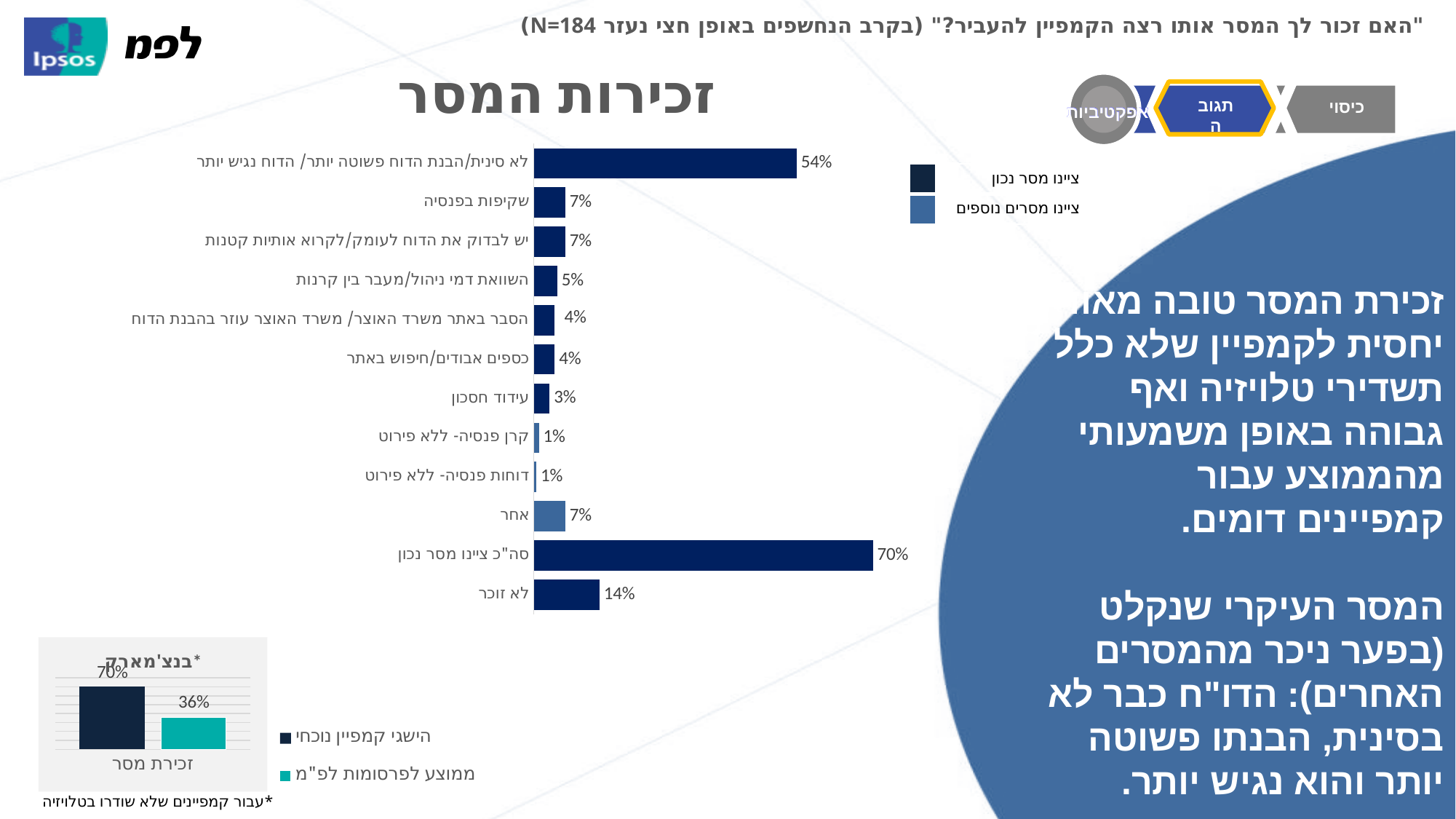
How many series does the legend of the chart titled "זכירות המסר" list? 2 In the chart titled "זכירות המסר", what is the value for "לא זוכר"? 14% In the chart titled "זכירות המסר", which category has the highest value? סה"כ ציינו מסר נכון What type of chart is the chart titled "זכירות המסר"? Bar chart In the chart titled "זכירות המסר", what is the value for "סה"כ ציינו מסר נכון"? 70% In the chart titled "זכירות המסר", what is the value for "לא סינית/הבנת הדוח פשוטה יותר/ הדוח נגיש יותר"? 54% In the chart titled "זכירות המסר", what is the value for "עידוד חסכון"? 3% In the small chart titled "בנצ'מארק" at the bottom left, what is the difference between "הישגי קמפיין נוכחי" and "ממוצע לפרסומות לפ"מ"? 34% How many categories are shown in the chart titled "זכירות המסר"? 12 In the small chart titled "בנצ'מארק" at the bottom left, what is the value for "ממוצע לפרסומות לפ"מ"? 36% In the chart titled "זכירות המסר", what is the difference between "סה"כ ציינו מסר נכון" and "לא זוכר"? 56% In the chart titled "זכירות המסר", which is larger: "שקיפות בפנסיה" or "השוואת דמי ניהול/מעבר בין קרנות"? שקיפות בפנסיה